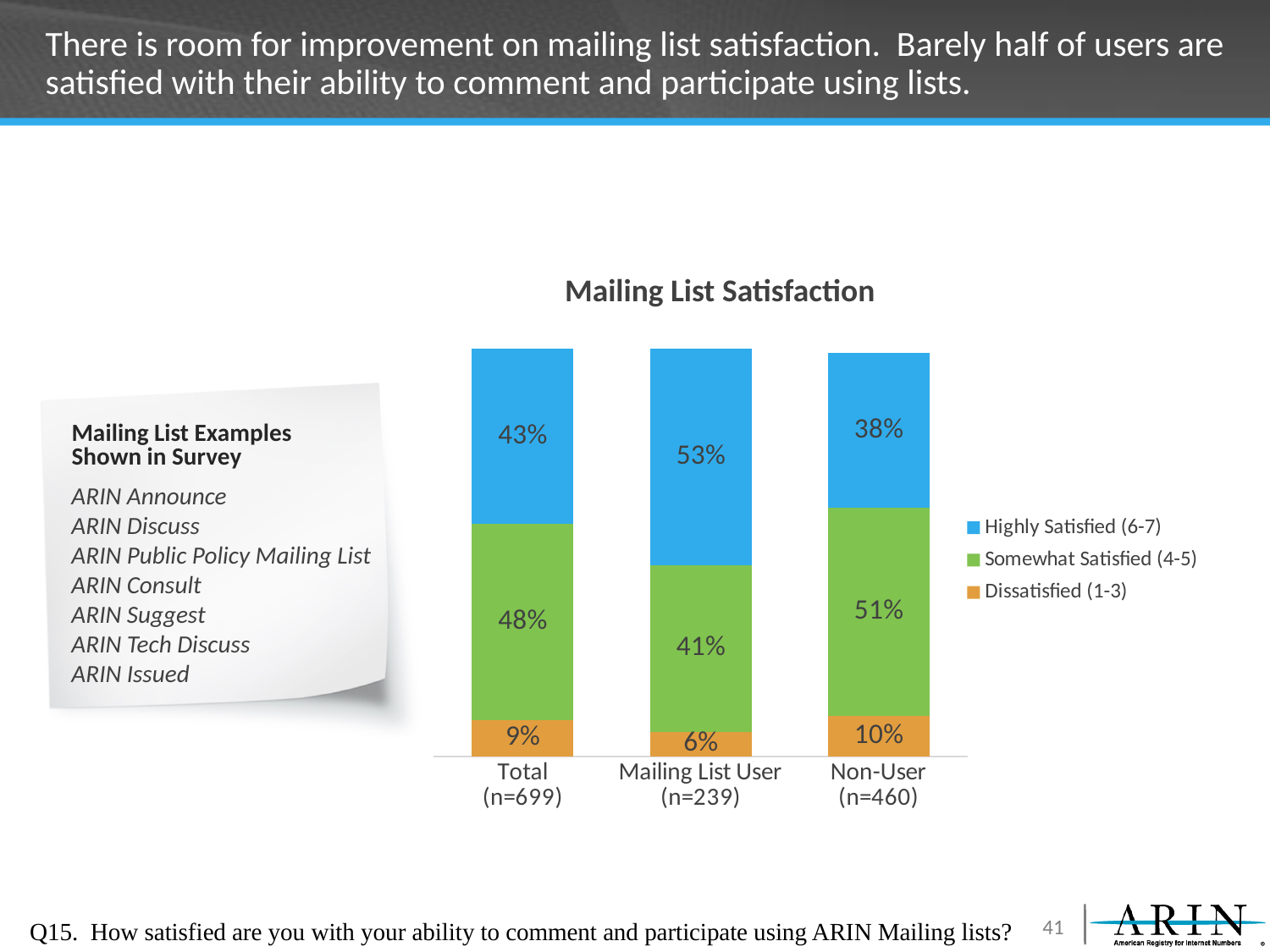
What is the total of the stacked bar for Non-User (n=460)? 99% What is the title of the chart? Mailing List Satisfaction What is the Dissatisfied (1-3) value for Non-User (n=460)? 10% What is the difference between the Highly Satisfied (6-7) values for Mailing List User (n=239) and Non-User (n=460)? 15% What is the Somewhat Satisfied (4-5) value for Total (n=699)? 48% How many series does the legend list? 3 What kind of chart is shown on the slide? Stacked bar chart Which category has the highest Highly Satisfied (6-7) value? Mailing List User (n=239) Which category has the lowest Dissatisfied (1-3) value? Mailing List User (n=239) How many categories are shown on the x axis? 3 What is the Highly Satisfied (6-7) value for Mailing List User (n=239)? 53% Which is larger: the Somewhat Satisfied (4-5) value for Total (n=699) or for Mailing List User (n=239)? Total (n=699)